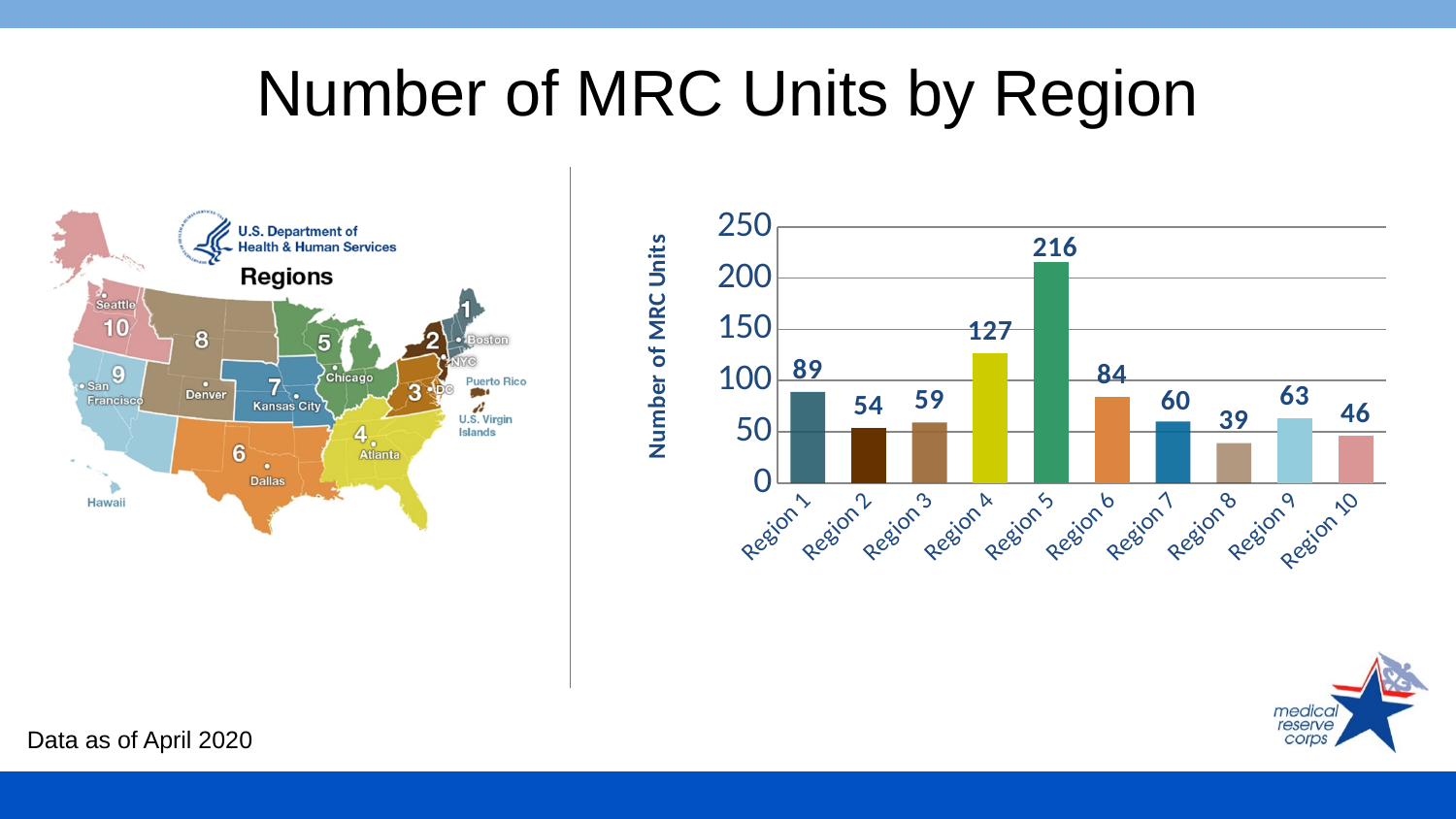
Is the value for Region 4 greater or less than 100? greater Which region has the highest number of MRC units? Region 5 Which has more MRC units, Region 7 or Region 9? Region 9 How many MRC units does Region 5 have? 216 How many regions are shown on the x axis of the chart? 10 What is the label of the vertical axis of the chart? Number of MRC Units What type of chart is used to show the number of MRC units by region? bar chart What is the difference in MRC units between Region 5 and Region 4? 89 What is the difference between the values for Region 1 and Region 6? 5 Which region has the lowest number of MRC units? Region 8 What is the value shown for Region 10? 46 What is the number of MRC units for Region 4? 127